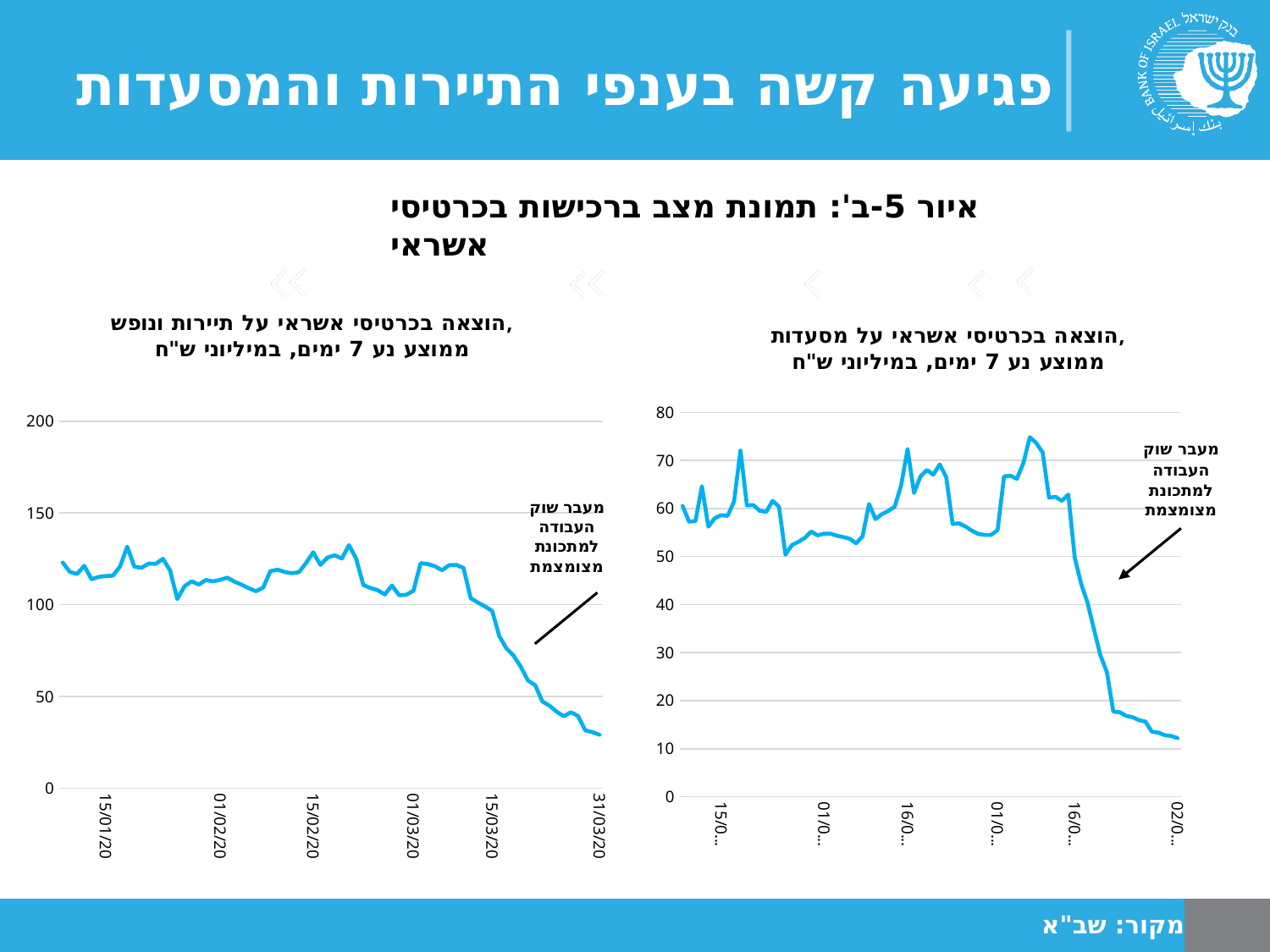
In the left chart (tourism and vacation spending), is the value at 15/01/20 greater or less than 100? greater What is the highest value shown on the y axis of the left chart (tourism and vacation spending)? 200 In the left chart (tourism and vacation spending), is the value at 01/03/20 greater or less than 150? less What kind of chart is the left chart (credit card spending on tourism and vacation)? line chart In the left chart (tourism and vacation spending), do the values rise or fall between 15/03/20 and 31/03/20? fall In the left chart (tourism and vacation spending), is the value at 31/03/20 greater or less than 50? less In the left chart (tourism and vacation spending), which is larger: the value at 15/01/20 or the value at 31/03/20? 15/01/20 In the right chart (restaurant spending), do the values rise or fall toward the right end of the x axis? fall What kind of chart is the right chart (credit card spending on restaurants)? line chart What is the last date label on the x axis of the left chart (tourism and vacation spending)? 31/03/20